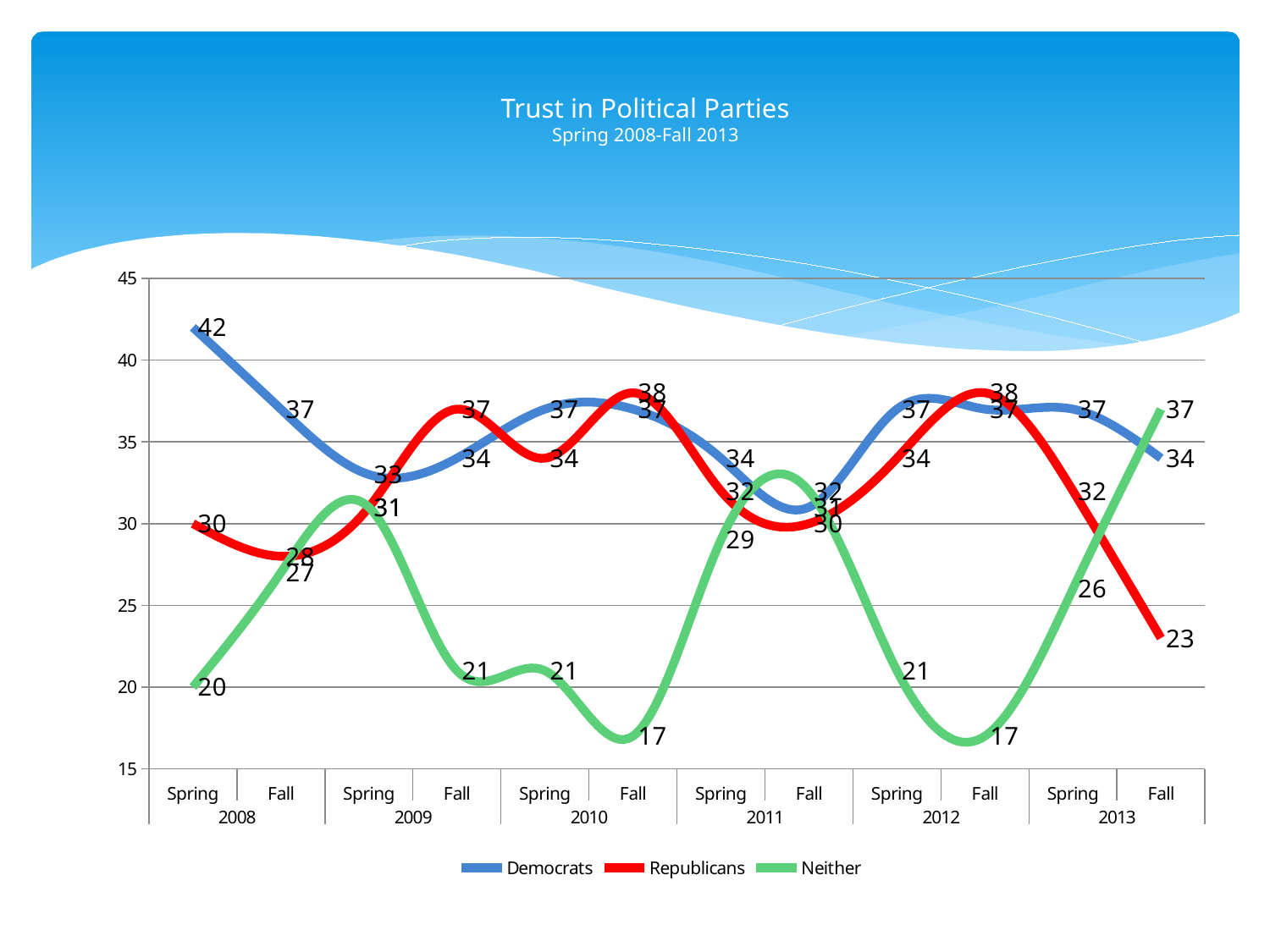
How many series does the legend list? 3 What is the value for Democrats in Spring 2008? 42 What kind of chart is shown on the slide? line chart What is the value for Republicans in Fall 2013? 23 What is the value for Neither in Fall 2013? 37 Is the value for Neither in Spring 2008 greater or less than 25? less What is the value for Neither in Fall 2010? 17 How many time points are shown on the x axis? 12 What is the difference between the Democrats values in Spring 2008 and Fall 2008? 5 In Fall 2013, which is larger: the Democrats value or the Republicans value? Democrats At which point does the Democrats series reach its highest value? Spring 2008 At which point does the Republicans series reach its lowest value? Fall 2013